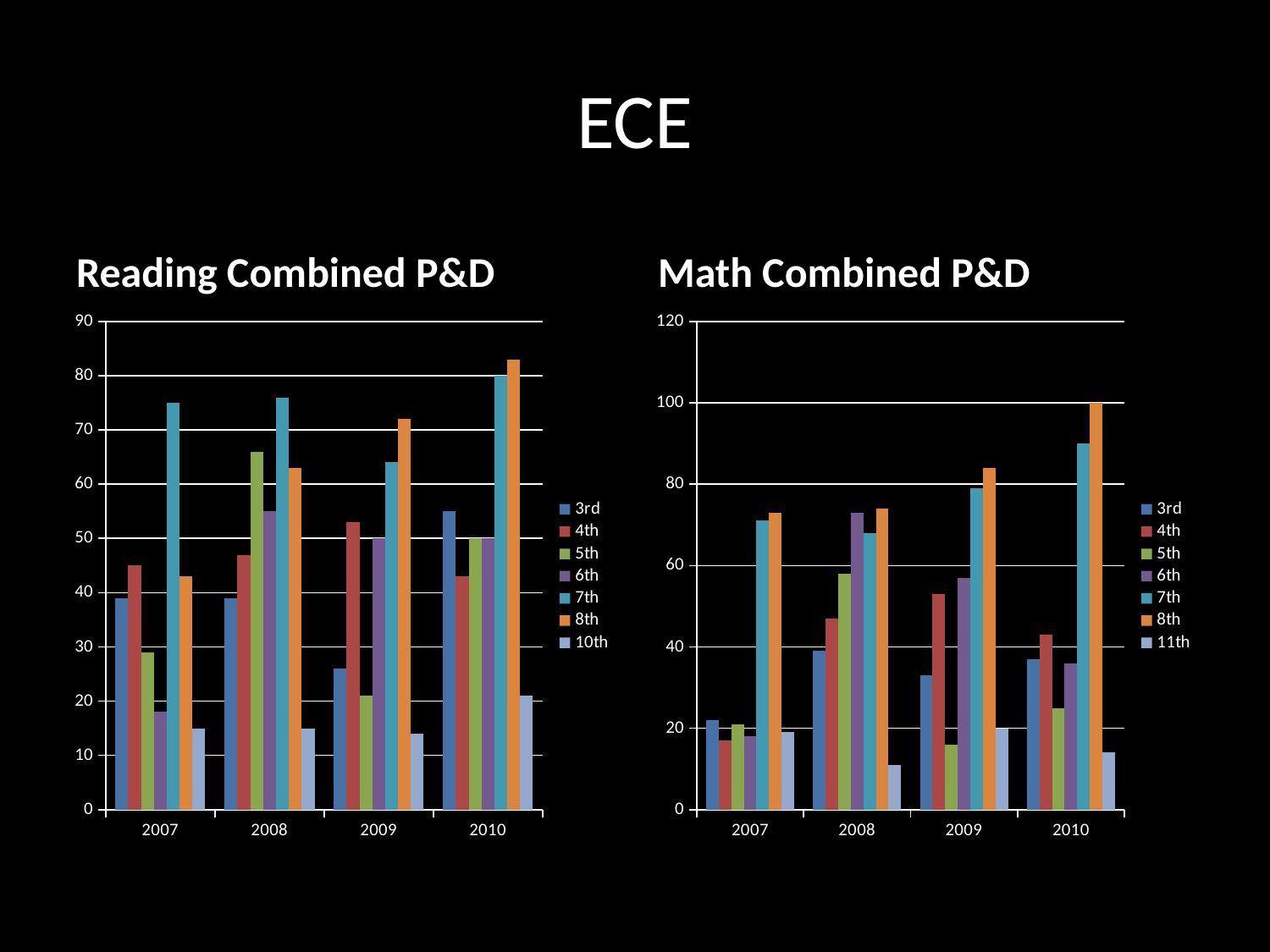
How many series does the legend of the Reading Combined P&D chart list? 7 In the Math Combined P&D chart, in which year is the 8th grade bar the tallest? 2010 How many years are shown on the x axis of the Math Combined P&D chart? 4 What kind of chart is the Reading Combined P&D chart? bar chart In the Reading Combined P&D chart, is the value for 7th grade in 2007 greater or less than 70? greater In the Math Combined P&D chart, which grade has the lowest value in 2008? 11th How many series does the legend of the Math Combined P&D chart list? 7 In the Math Combined P&D chart, which is larger in 2009: 4th grade or 5th grade? 4th grade In the Reading Combined P&D chart, do the 8th grade values rise or fall from 2007 to 2010? rise In the Reading Combined P&D chart, which is larger in 2010: 3rd grade or 4th grade? 3rd grade In the Math Combined P&D chart, what is the value for 8th grade in 2010? 100 In the Math Combined P&D chart, is the value for 11th grade in 2008 greater or less than 20? less